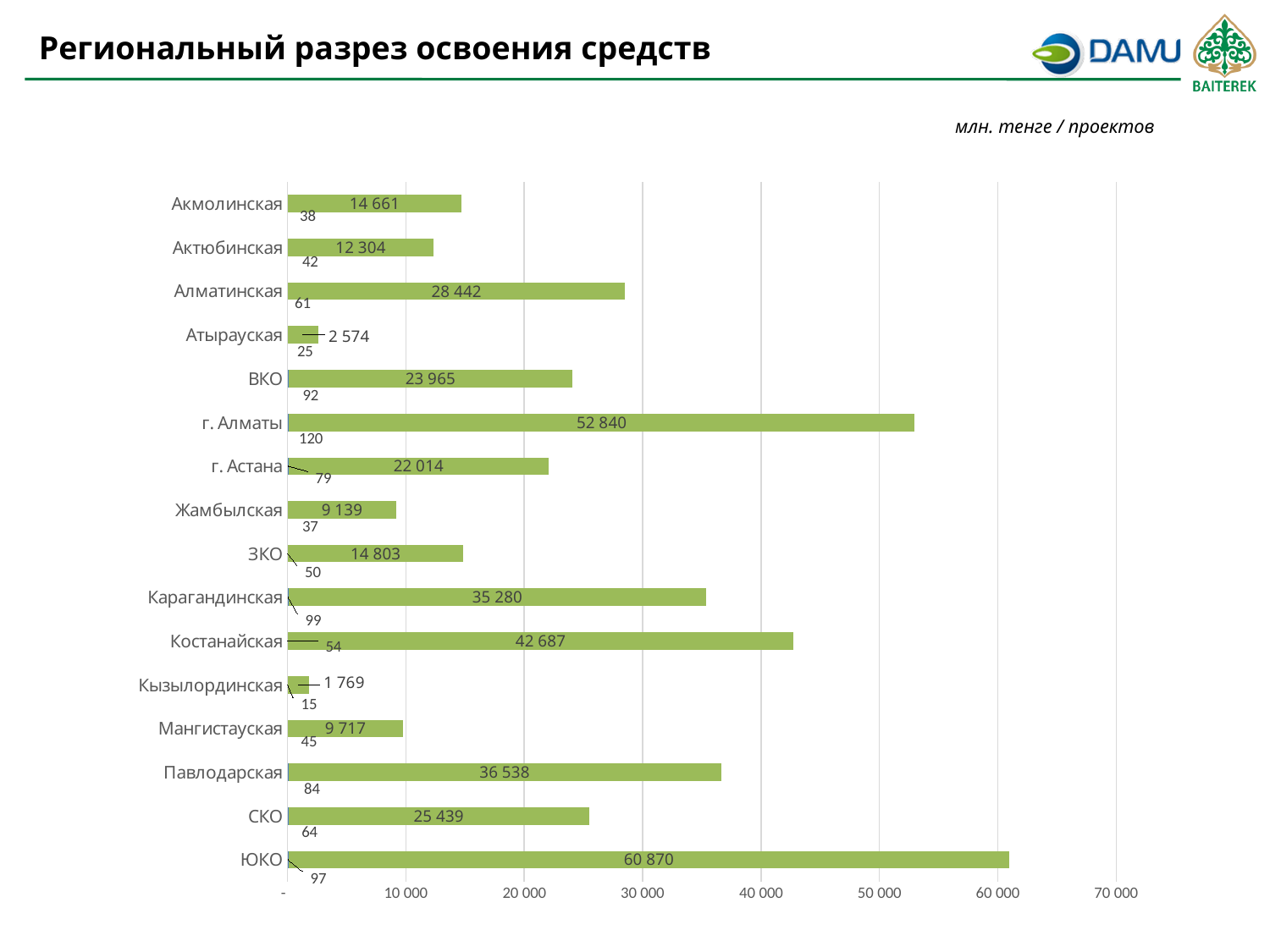
Is the value for Алматинская greater or less than 30 000? less Which has a larger value in million tenge, Павлодарская or Карагандинская? Павлодарская What is the title of the chart on the slide? Региональный разрез освоения средств Which region has the lowest value in million tenge? Кызылординская Which region has the highest value in million tenge? ЮКО What kind of chart is shown on the slide? bar chart What is the value in million tenge for г. Алматы? 52 840 What is the difference in million tenge between ЮКО and г. Алматы? 8 030 How many projects are shown for ВКО? 92 How many regions are shown on the chart? 16 What is the value in million tenge for Костанайская? 42 687 Which region has the highest number of projects? г. Алматы